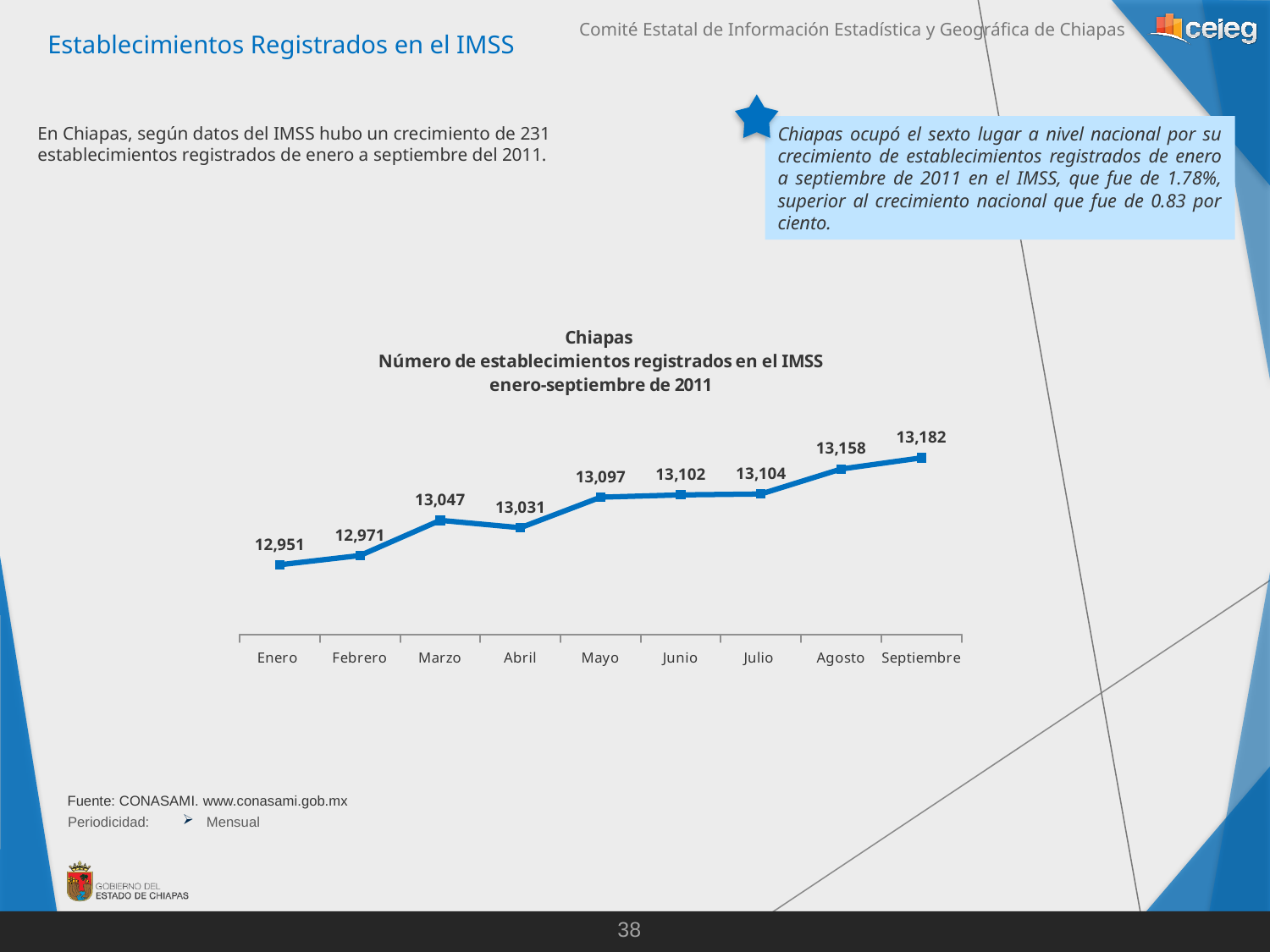
What is the number of establishments registered in the IMSS in Chiapas in Enero? 12,951 Which is larger, the value for Marzo or the value for Abril? Marzo What is the difference between the values for Marzo and Abril? 16 What value is shown for Agosto? 13,158 Which month has the lowest number of registered establishments? Enero What kind of chart is shown on the slide? Line chart What value is shown for Mayo? 13,097 Do the values generally rise or fall from Enero to Septiembre? Rise What is the title of the chart? Chiapas Número de establecimientos registrados en el IMSS enero-septiembre de 2011 How many months are plotted on the chart? 9 Which month has the highest number of registered establishments? Septiembre What is the difference between the values for Septiembre and Enero? 231